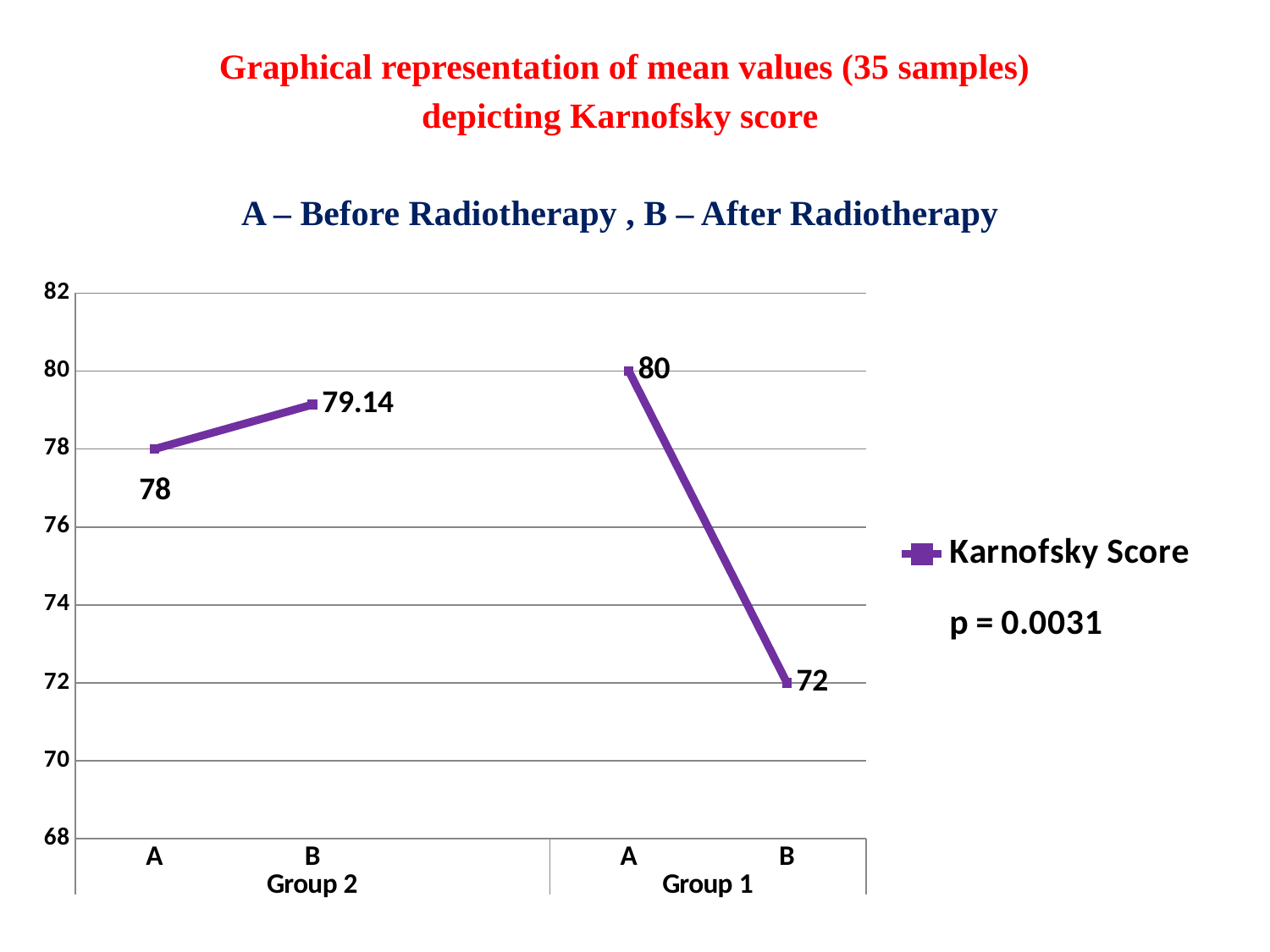
What kind of chart is shown on the slide? Line chart What is the Karnofsky score for Group 2 at point B (after radiotherapy)? 79.14 What is the Karnofsky score for Group 2 at point A (before radiotherapy)? 78 Which is larger, the Karnofsky score for Group 2 at B or for Group 1 at B? Group 2 at B How many data points are plotted on the chart? 4 What is the Karnofsky score for Group 1 at point A (before radiotherapy)? 80 What is the Karnofsky score for Group 1 at point B (after radiotherapy)? 72 Which data point has the lowest Karnofsky score? Group 1, B What p-value is shown next to the legend? p = 0.0031 Which data point has the highest Karnofsky score? Group 1, A What is the difference between the Karnofsky scores at A and B for Group 1? 8 How many series does the legend list? 1